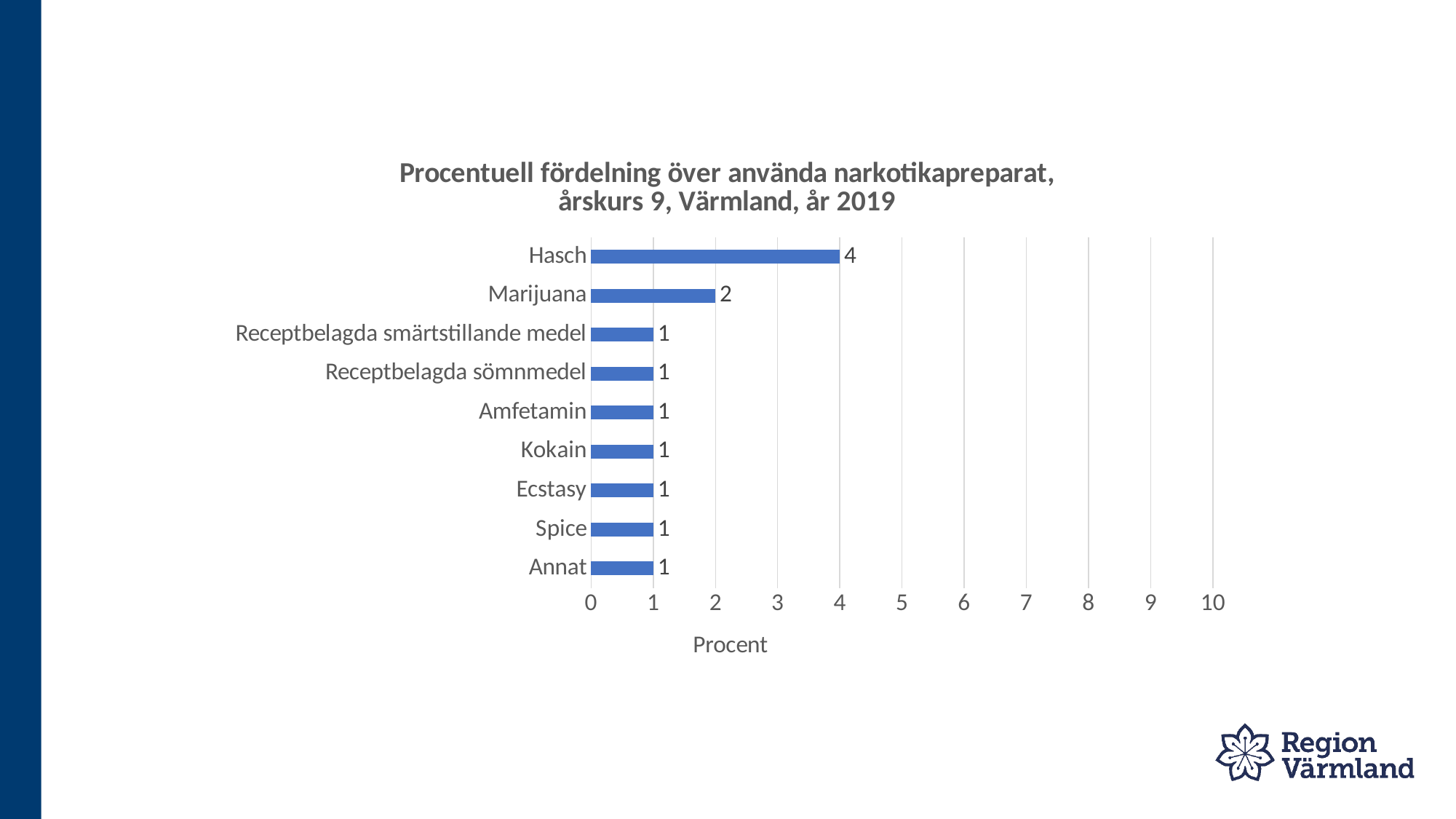
What is the label of the horizontal axis? Procent Which category has the highest value? Hasch Which is larger, the value for Hasch or the value for Amfetamin? Hasch What is the value for Receptbelagda sömnmedel? 1 What is the value for Kokain? 1 What is the value for Marijuana? 2 How many categories are shown in the chart? 9 What is the difference between the values for Marijuana and Spice? 1 What is the value for Hasch? 4 What kind of chart is shown on the slide? bar chart What is the difference between the values for Hasch and Marijuana? 2 Is the value for Hasch greater or less than 3? greater